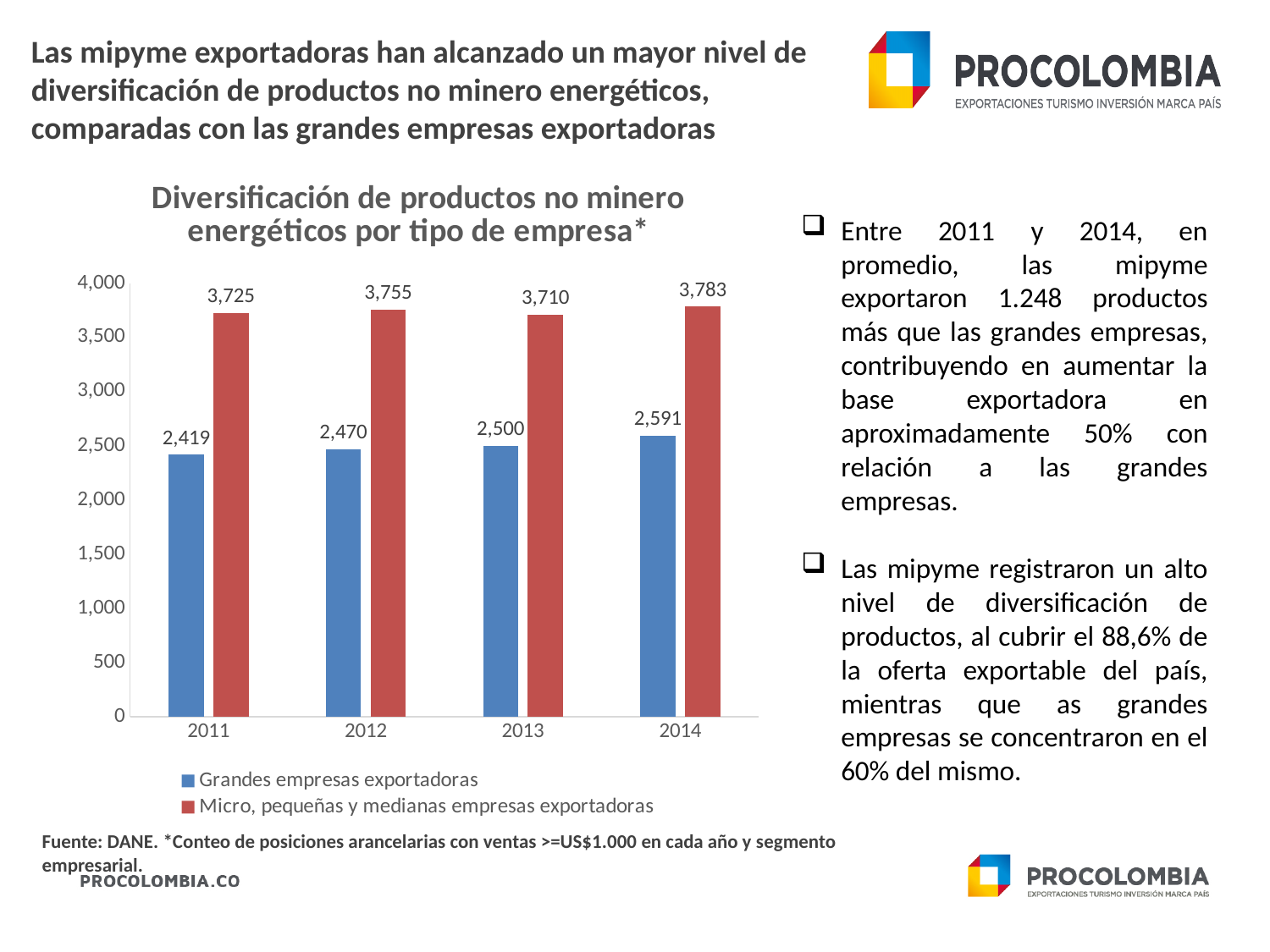
What is the value for Micro, pequeñas y medianas empresas exportadoras in 2014? 3,783 How many years are shown on the x axis? 4 What is the value for Grandes empresas exportadoras in 2011? 2,419 What is the difference between the two series in 2012? 1,285 Do the values for Grandes empresas exportadoras rise or fall from 2011 to 2014? Rise What is the value for Micro, pequeñas y medianas empresas exportadoras in 2013? 3,710 In which year is the value for Micro, pequeñas y medianas empresas exportadoras highest? 2014 What colour are the bars for Micro, pequeñas y medianas empresas exportadoras? Red In which year is the value for Grandes empresas exportadoras lowest? 2011 How many series does the legend list? 2 What kind of chart is shown? Bar chart Which series has the larger value in 2013? Micro, pequeñas y medianas empresas exportadoras